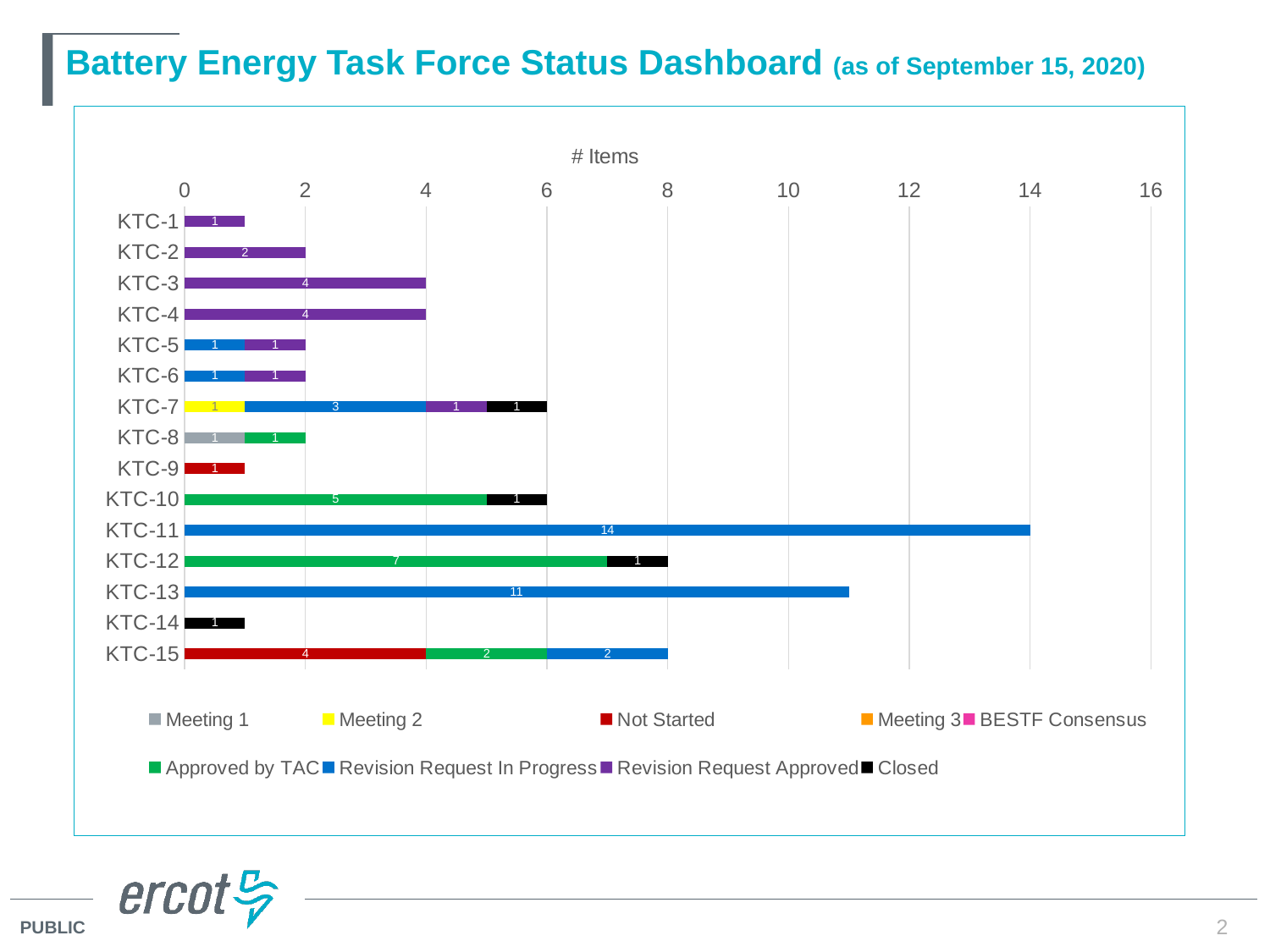
What is the total number of items for KTC-15? 8 What is the value of Approved by TAC for KTC-12? 7 What is the value of Not Started for KTC-15? 4 How many series does the legend list? 9 Which KTC has the longest total bar? KTC-11 What is the value of Revision Request In Progress for KTC-7? 3 What is the total number of items for KTC-7? 6 What is the difference between the Revision Request In Progress values for KTC-11 and KTC-13? 3 How many KTC categories are shown on the chart? 15 Which has a larger Approved by TAC value, KTC-10 or KTC-12? KTC-12 What kind of chart is shown on the slide? Stacked bar chart What is the value of Revision Request In Progress for KTC-11? 14